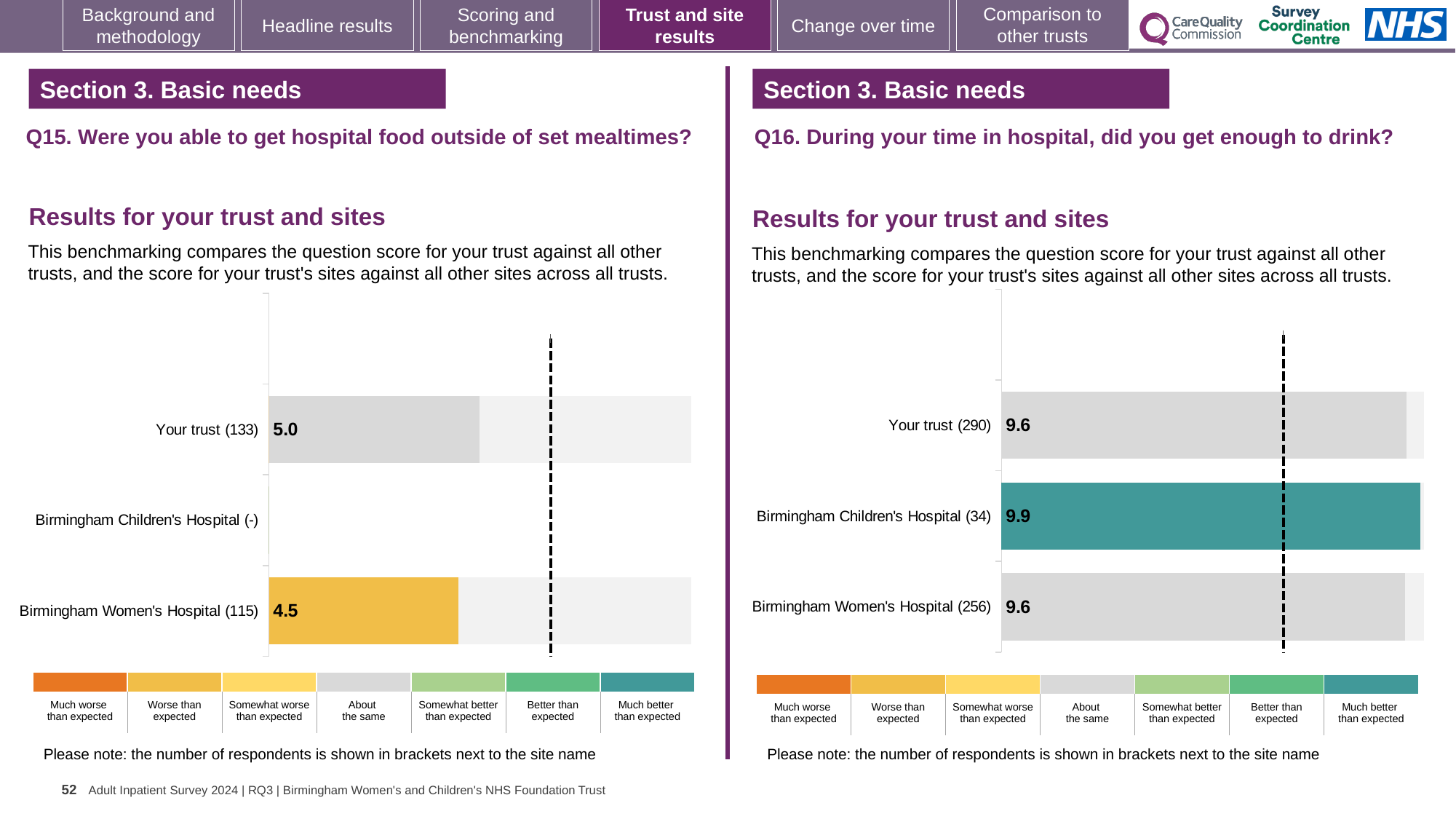
On the Q15 chart (left), what is the difference between the score for Your trust and the score for Birmingham Women's Hospital? 0.5 On the Q15 chart (left), what is the score for Birmingham Women's Hospital? 4.5 On the Q16 chart (right), how many respondents are shown in brackets for Your trust? 290 On the Q15 chart (left), what is the score for Your trust? 5.0 On the Q16 chart (right), which benchmark category does the colour of the Birmingham Children's Hospital bar correspond to in the legend? Much better than expected On the Q15 chart (left), which has the higher score: Your trust or Birmingham Women's Hospital? Your trust On the Q16 chart (right), what is the score for Birmingham Children's Hospital? 9.9 On the Q16 chart (right), what is the difference between the score for Birmingham Children's Hospital and the score for Birmingham Women's Hospital? 0.3 On the Q16 chart (right), which site has the highest score? Birmingham Children's Hospital On the Q15 chart (left), how many respondents are shown in brackets for Birmingham Women's Hospital? 115 On the Q16 chart (right), what is the score for Your trust? 9.6 What kind of chart is used on the Q15 chart (left)? Bar chart